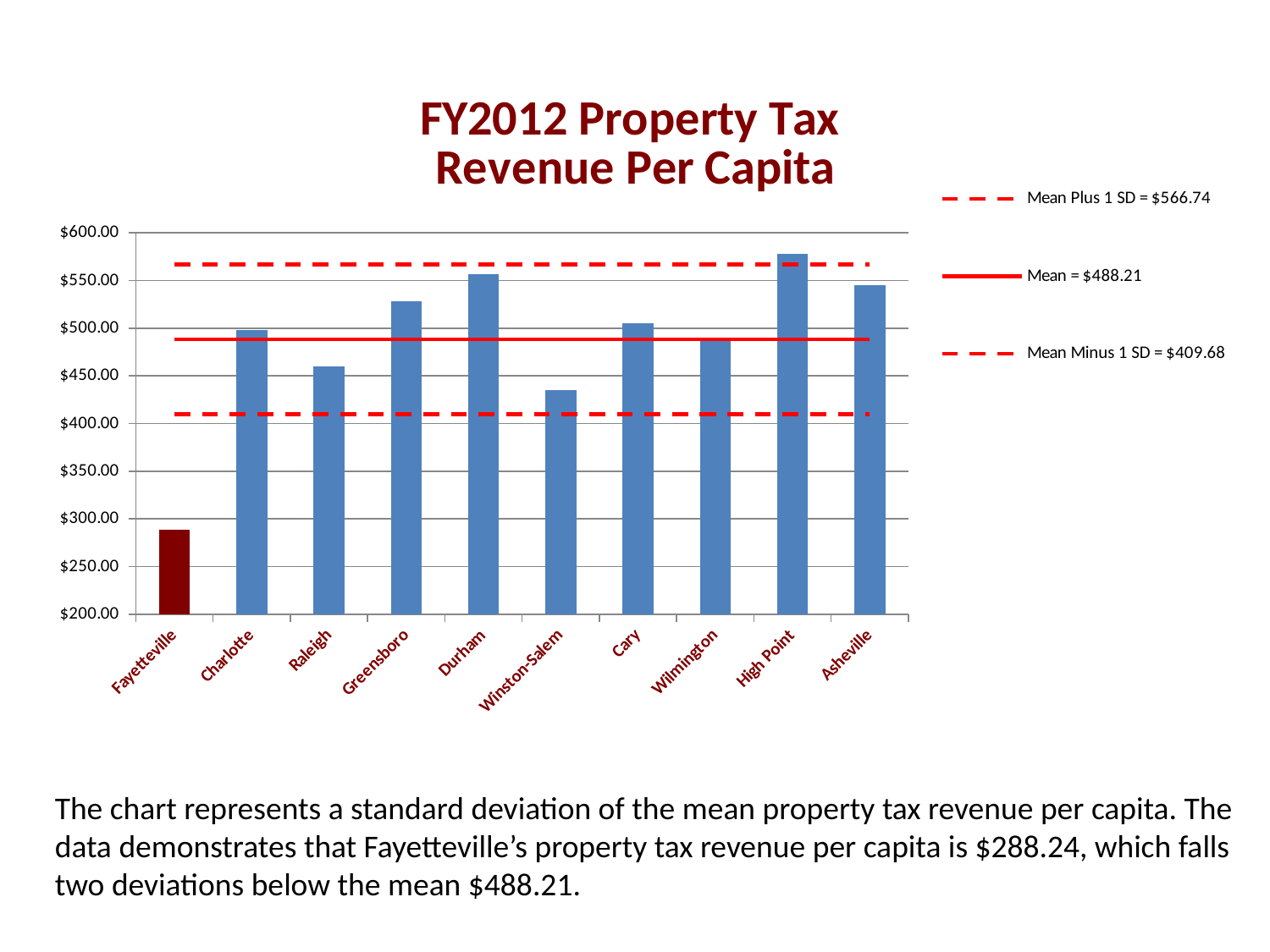
Which city has the highest property tax revenue per capita in the chart? High Point What is the mean value shown in the chart legend? $488.21 Which city has the lowest property tax revenue per capita in the chart? Fayetteville Which city has the larger value, Durham or Cary? Durham What value does the legend give for Mean Minus 1 SD? $409.68 Is the value for Winston-Salem greater or less than $450.00? less Is the value for Greensboro greater or less than $500.00? greater What kind of chart is shown on the slide? Bar chart How many entries does the chart legend list? 3 How many cities are plotted on the x axis of the chart? 10 What value does the legend give for Mean Plus 1 SD? $566.74 What is Fayetteville's property tax revenue per capita according to the slide? $288.24